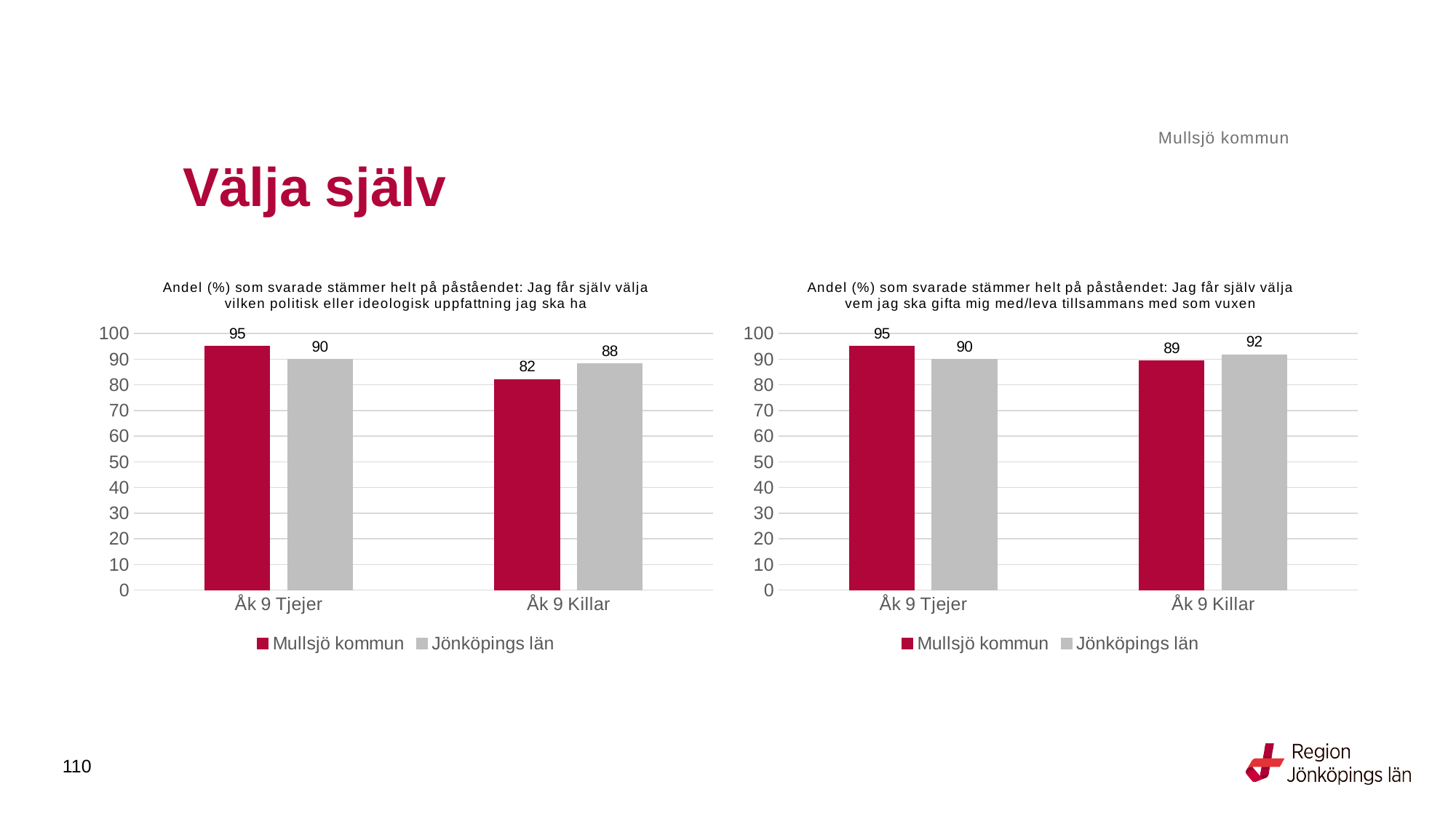
In the right chart (whom to marry/live with), which is larger for Åk 9 Killar: Mullsjö kommun or Jönköpings län? Jönköpings län What kind of chart is the left chart? Bar chart In the right chart (whom to marry/live with), what is the value for Jönköpings län for Åk 9 Killar? 92 How many series does the legend of the left chart list? 2 How many categories are shown on the x axis of the right chart? 2 In the left chart (political or ideological opinion), what is the difference between Mullsjö kommun and Jönköpings län for Åk 9 Killar? 6 In the left chart (political or ideological opinion), what is the value for Jönköpings län for Åk 9 Killar? 88 In the right chart (whom to marry/live with), what is the value for Mullsjö kommun for Åk 9 Killar? 89 In the right chart (whom to marry/live with), which bar has the highest value? Mullsjö kommun, Åk 9 Tjejer In the left chart (political or ideological opinion), which bar has the lowest value? Mullsjö kommun, Åk 9 Killar In the right chart (whom to marry/live with), what is the difference between Mullsjö kommun and Jönköpings län for Åk 9 Tjejer? 5 In the left chart (political or ideological opinion), what is the value for Mullsjö kommun for Åk 9 Tjejer? 95